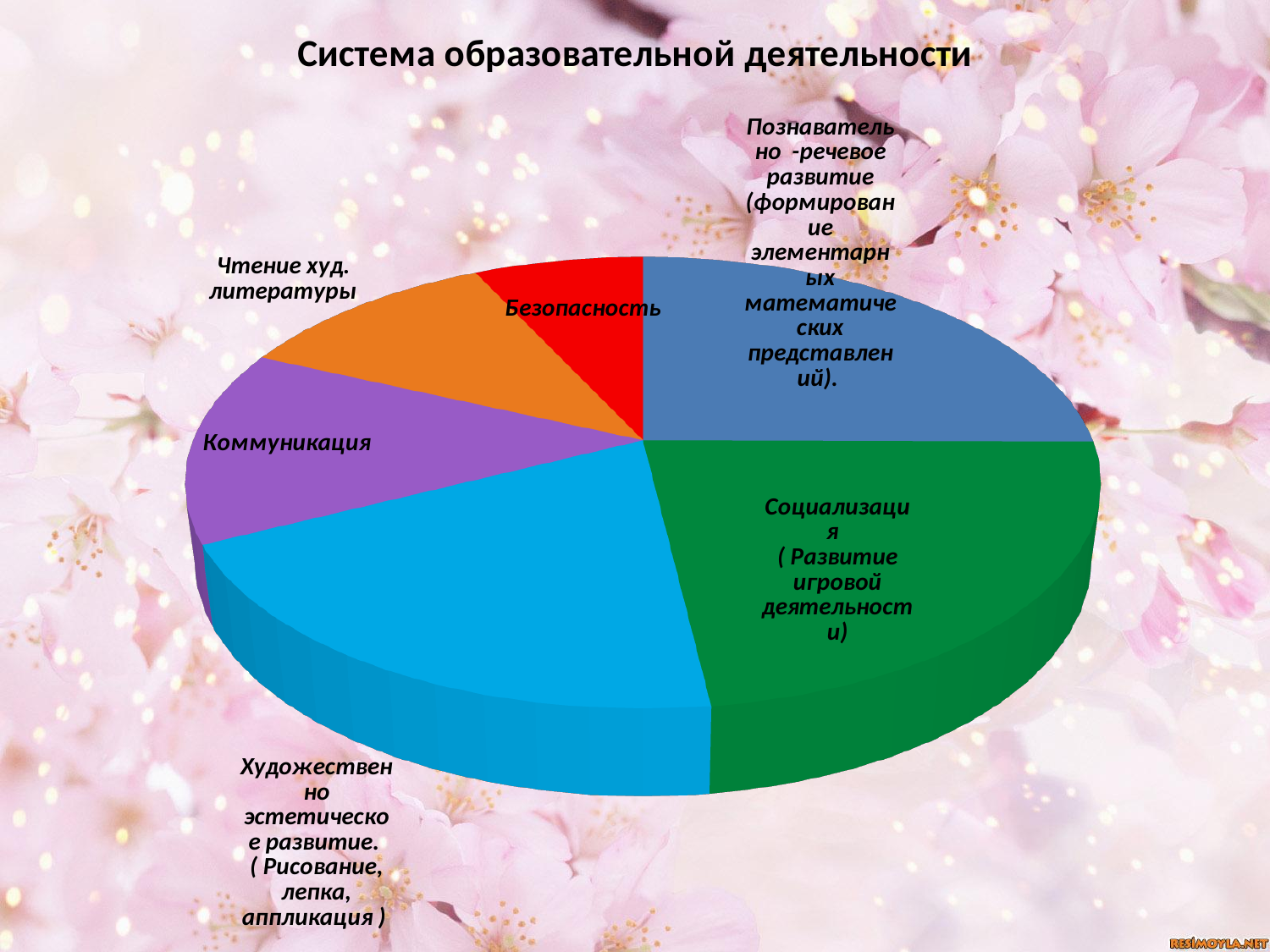
What colour is the Безопасность slice? red How many slices does the pie chart have? 6 Which slice is larger: Коммуникация or Безопасность? Коммуникация Which slice of the pie chart is the largest? Познавательно-речевое развитие (формирование элементарных математических представлений) Which slice is larger: Социализация or Чтение худ. литературы? Социализация Which slice is larger: Художественно эстетическое развитие or Коммуникация? Художественно эстетическое развитие What kind of chart is shown on the slide? pie chart Which slice of the pie chart is the smallest? Безопасность What is the title of the chart? Система образовательной деятельности